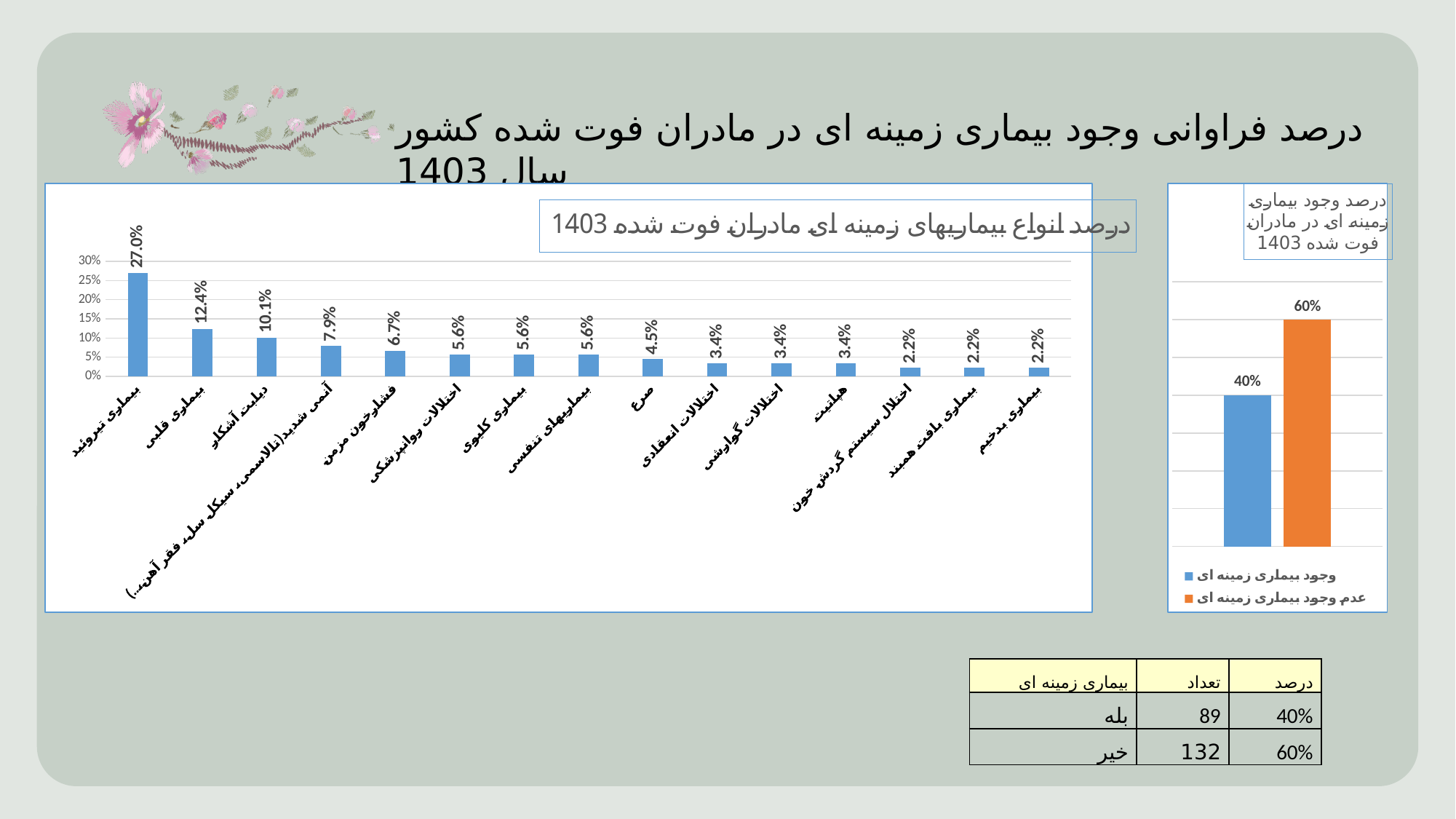
In the left chart, which category has the highest value? بیماری تیروئید In the left chart, what is the difference between the values for بیماری تیروئید and بیماری قلبی? 14.6% What kind of chart is the left chart? bar chart In the left chart, is the value for بیماری تیروئید greater or less than 25%? greater How many series does the legend of the right chart list? 2 In the left chart (درصد انواع بیماریهای زمینه ای مادران فوت شده 1403), what is the value for بیماری تیروئید? 27.0% How many categories are shown in the left chart? 15 In the right chart, what is the value for وجود بیماری زمینه ای? 40% In the left chart, what is the value for بیماری قلبی? 12.4% In the right chart (درصد وجود بیماری زمینه ای در مادران فوت شده 1403), what is the value for عدم وجود بیماری زمینه ای? 60% In the left chart, what is the value for صرع? 4.5% In the left chart, which is larger: the value for دیابت آشکار or the value for فشارخون مزمن? دیابت آشکار